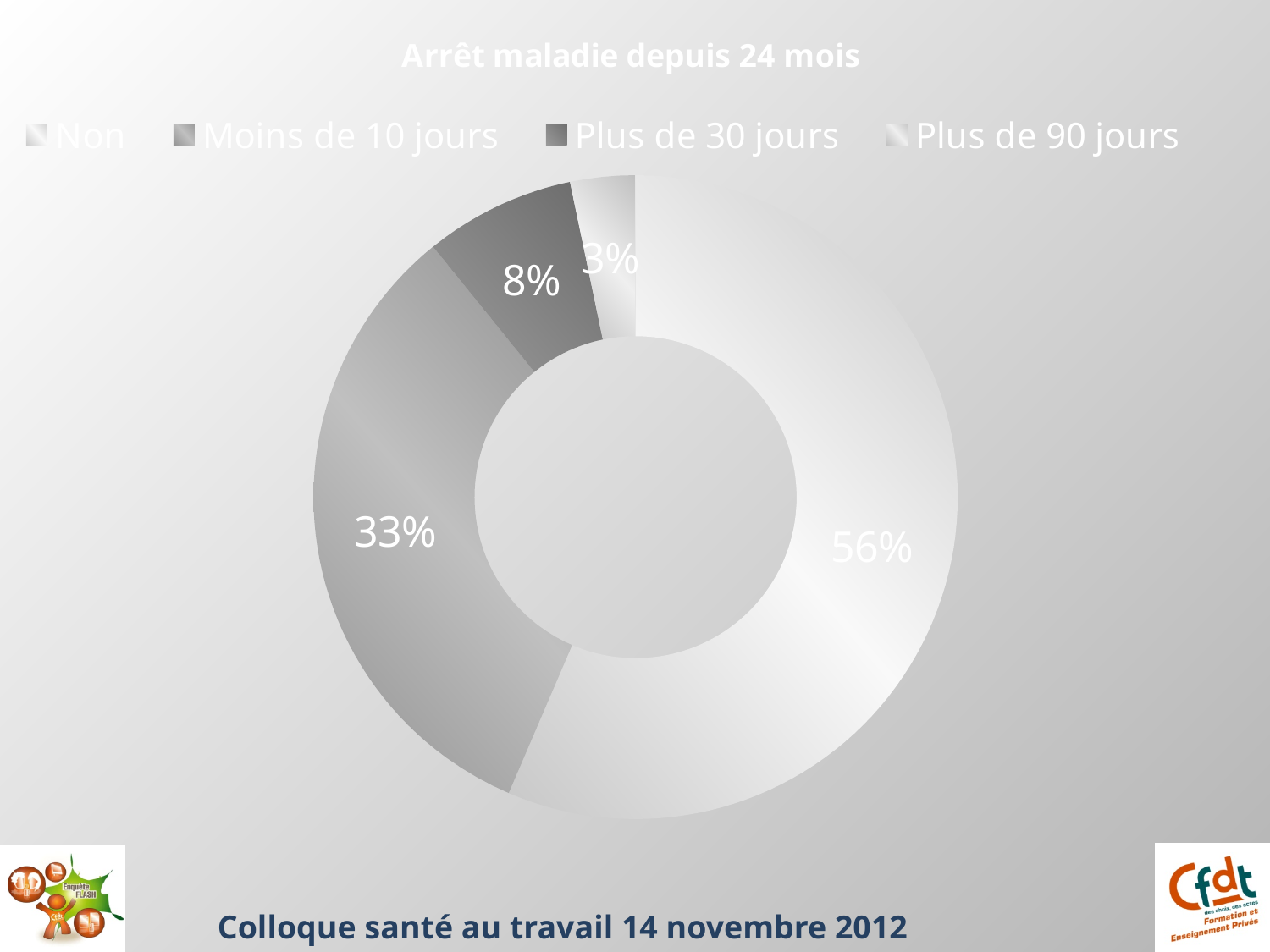
Which is larger, the share for 'Plus de 30 jours' or for 'Plus de 90 jours'? Plus de 30 jours What percentage is shown for 'Plus de 90 jours'? 3% What is the title of the chart? Arrêt maladie depuis 24 mois Which category has the largest share of the chart? Non How many categories does the legend list? 4 What is the combined share of 'Plus de 30 jours' and 'Plus de 90 jours'? 11% What percentage is shown for 'Moins de 10 jours'? 33% What percentage is shown for 'Plus de 30 jours'? 8% What is the difference between the shares for 'Non' and 'Moins de 10 jours'? 23% What percentage is shown for 'Non'? 56% Which category has the smallest share of the chart? Plus de 90 jours What kind of chart is shown on the slide? Doughnut (pie) chart